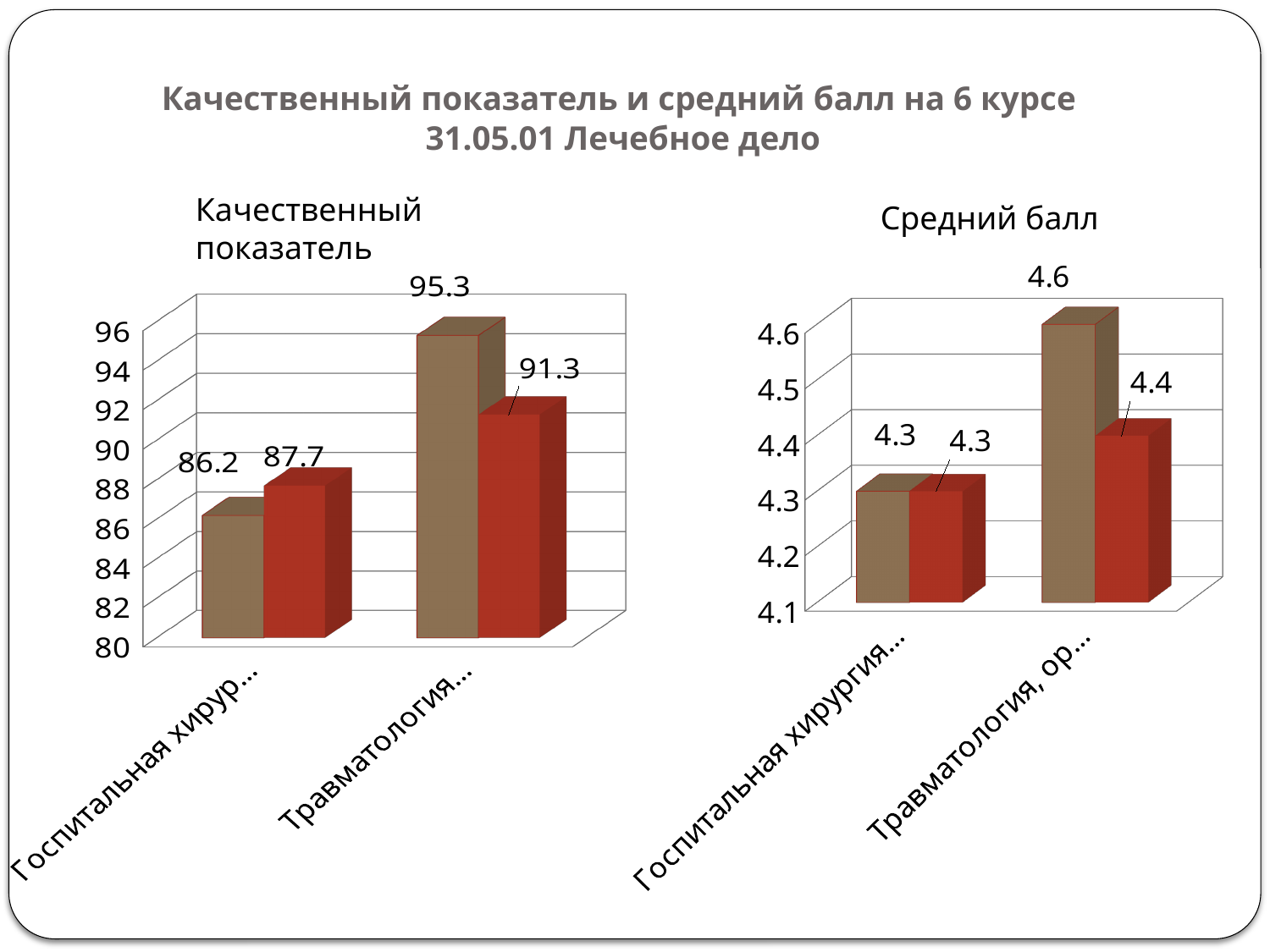
In the chart titled "Качественный показатель", what is the value of the brown (first) bar for Госпитальная хирургия? 86.2 In the chart titled "Средний балл", what is the value of the red (second) bar for Госпитальная хирургия? 4.3 What is the main title of the slide above the two charts? Качественный показатель и средний балл на 6 курсе 31.05.01 Лечебное дело In the chart titled "Средний балл", what is the lowest value shown? 4.3 In the chart titled "Качественный показатель", what is the difference between the two bars for Травматология (95.3 and 91.3)? 4 How many categories are shown on the x axis of the chart titled "Средний балл"? 2 What kind of chart is the chart titled "Качественный показатель"? bar chart In the chart titled "Качественный показатель", what is the value of the red (second) bar for Травматология? 91.3 In the chart titled "Качественный показатель", what is the highest value shown? 95.3 In the chart titled "Средний балл", what is the difference between the two bars for Травматология (4.6 and 4.4)? 0.2 In the chart titled "Качественный показатель", which bar for Госпитальная хирургия is larger, the brown one or the red one? the red one (87.7) In the chart titled "Средний балл", what is the value of the brown (first) bar for Травматология? 4.6